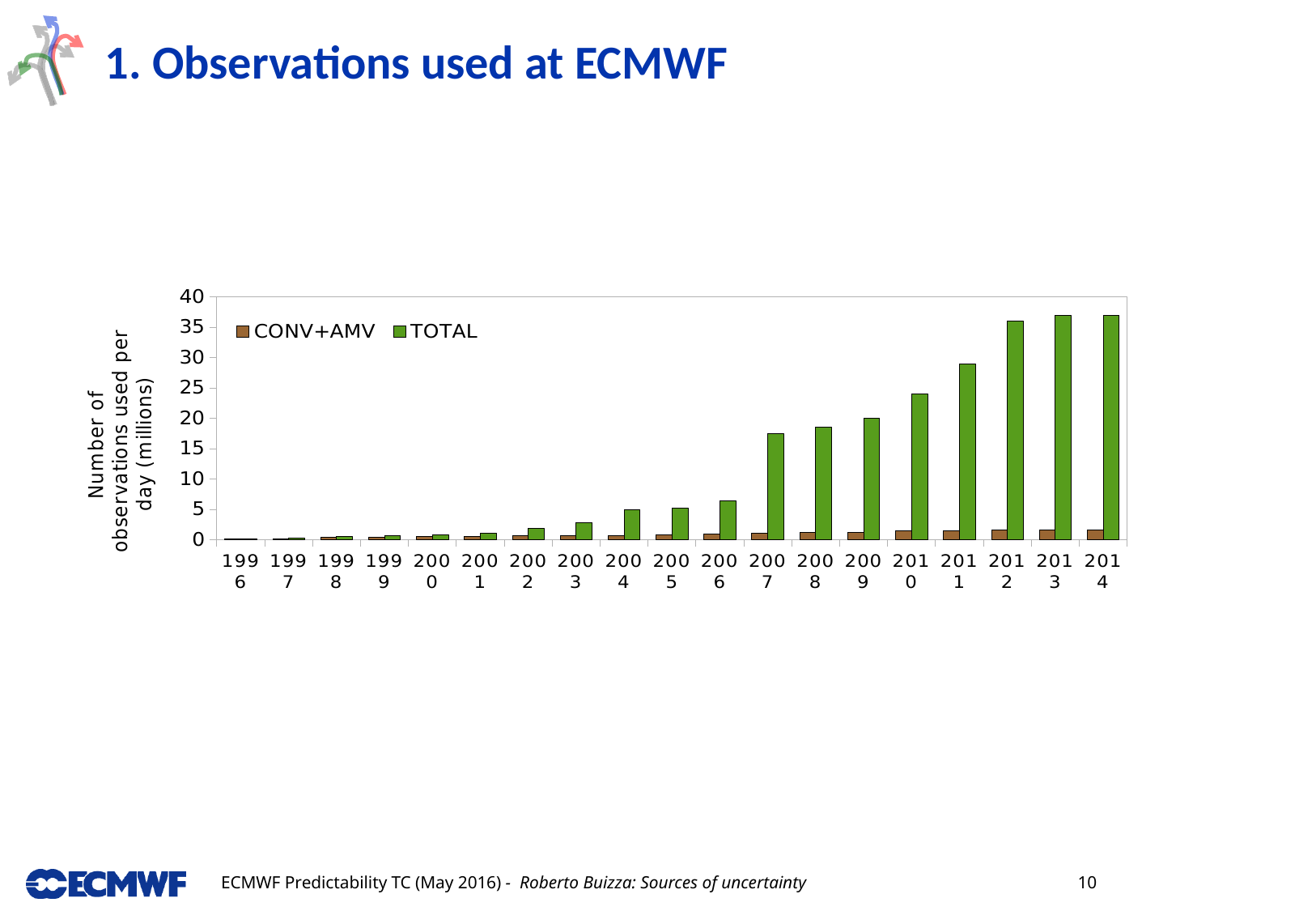
Is the CONV+AMV value for 2014 greater or less than 5? less Is the TOTAL value for 2011 greater or less than 25? greater How many years are shown along the x axis? 19 How many series does the legend list? 2 What is the y-axis label of the chart? Number of observations used per day (millions) Is the TOTAL value for 2007 greater or less than 15? greater What kind of chart is shown on the slide? bar chart Which year has the lowest TOTAL value? 1996 What are the two series named in the legend? CONV+AMV and TOTAL Do the TOTAL values generally rise or fall from 1996 to 2014? rise Which is larger, the TOTAL value for 2011 or the TOTAL value for 2010? 2011